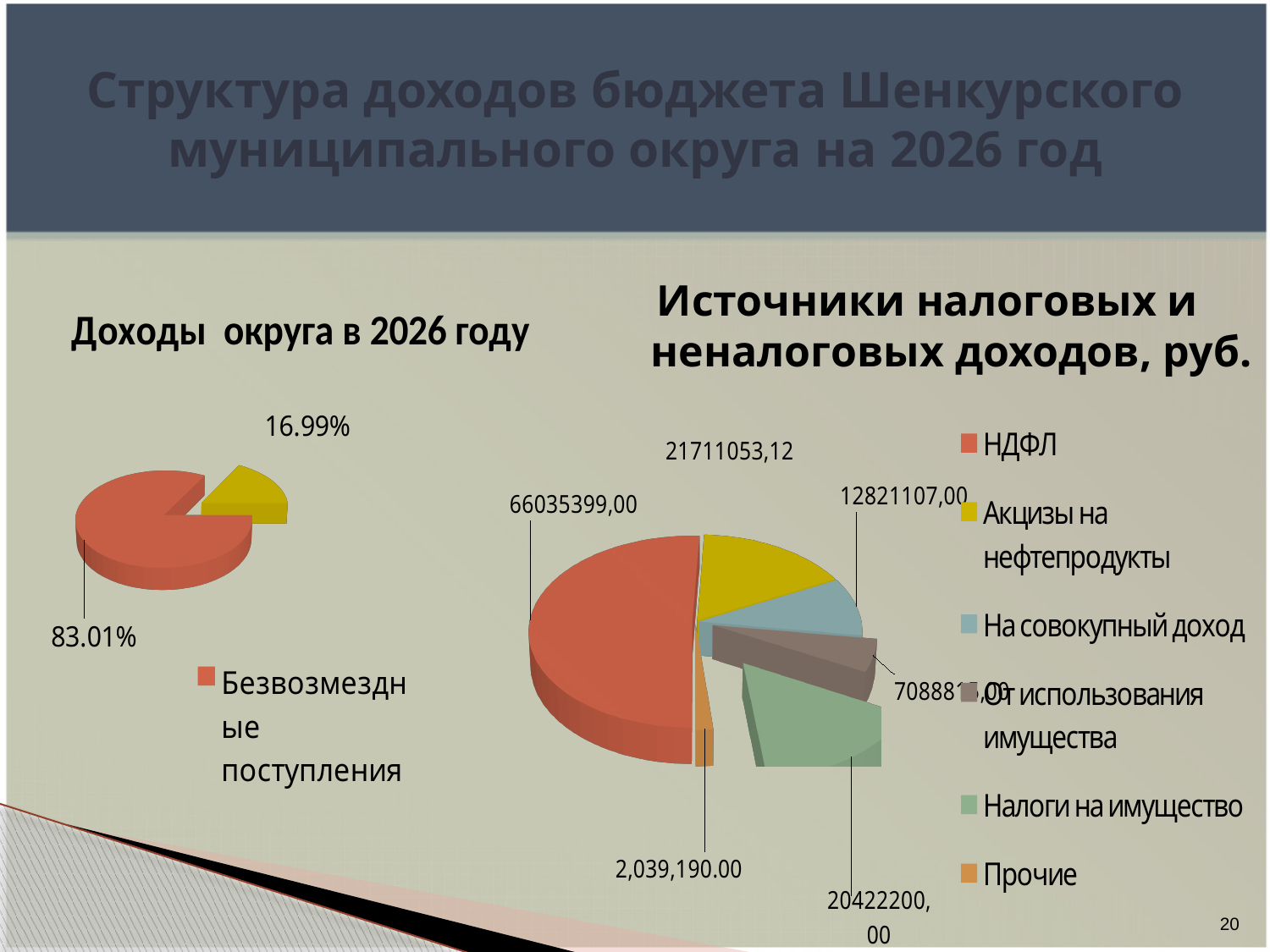
In the right chart "Источники налоговых и неналоговых доходов, руб.", what is the value for Прочие? 2,039,190.00 How many categories does the legend of the right chart "Источники налоговых и неналоговых доходов, руб." list? 6 How many slices does the left chart "Доходы округа в 2026 году" have? 2 In the right chart "Источники налоговых и неналоговых доходов, руб.", which category has the largest value? НДФЛ In the right chart "Источники налоговых и неналоговых доходов, руб.", what is the value for Налоги на имущество? 20422200,00 In the right chart "Источники налоговых и неналоговых доходов, руб.", which category has the smallest value? Прочие In the right chart "Источники налоговых и неналоговых доходов, руб.", what is the value for НДФЛ? 66035399,00 In the left chart "Доходы округа в 2026 году", what share is shown for Безвозмездные поступления? 83.01% What kind of chart is the left chart titled "Доходы округа в 2026 году"? pie chart In the right chart "Источники налоговых и неналоговых доходов, руб.", which is larger: Акцизы на нефтепродукты or Налоги на имущество? Акцизы на нефтепродукты In the right chart "Источники налоговых и неналоговых доходов, руб.", what is the value for На совокупный доход? 12821107,00 In the right chart "Источники налоговых и неналоговых доходов, руб.", what is the value for Акцизы на нефтепродукты? 21711053,12